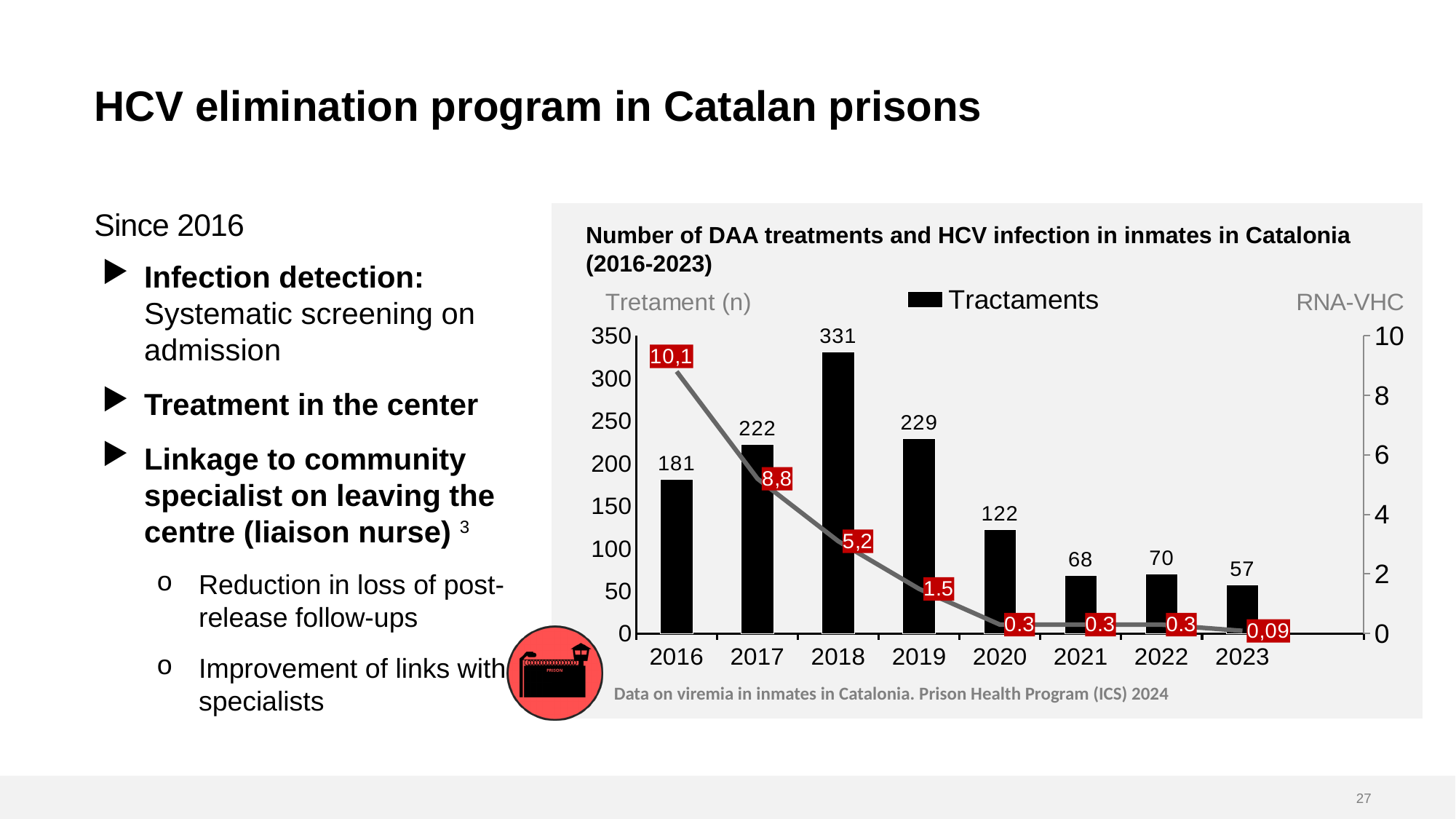
Which year has the lowest number of treatments? 2023 What RNA-VHC value is labelled on the line for 2016? 10,1 What is the number of treatments shown for 2023? 57 What is the label of the right-hand vertical axis? RNA-VHC Does the RNA-VHC line rise or fall from 2016 to 2023? Falls How many DAA treatments were given in 2018? 331 What type of chart is used to show the number of treatments? Bar chart Which year has the highest number of treatments? 2018 How many years are shown on the x axis? 8 Which year had more treatments, 2017 or 2019? 2019 What RNA-VHC value is labelled on the line for 2019? 1.5 What is the difference in the number of treatments between 2018 and 2019? 102